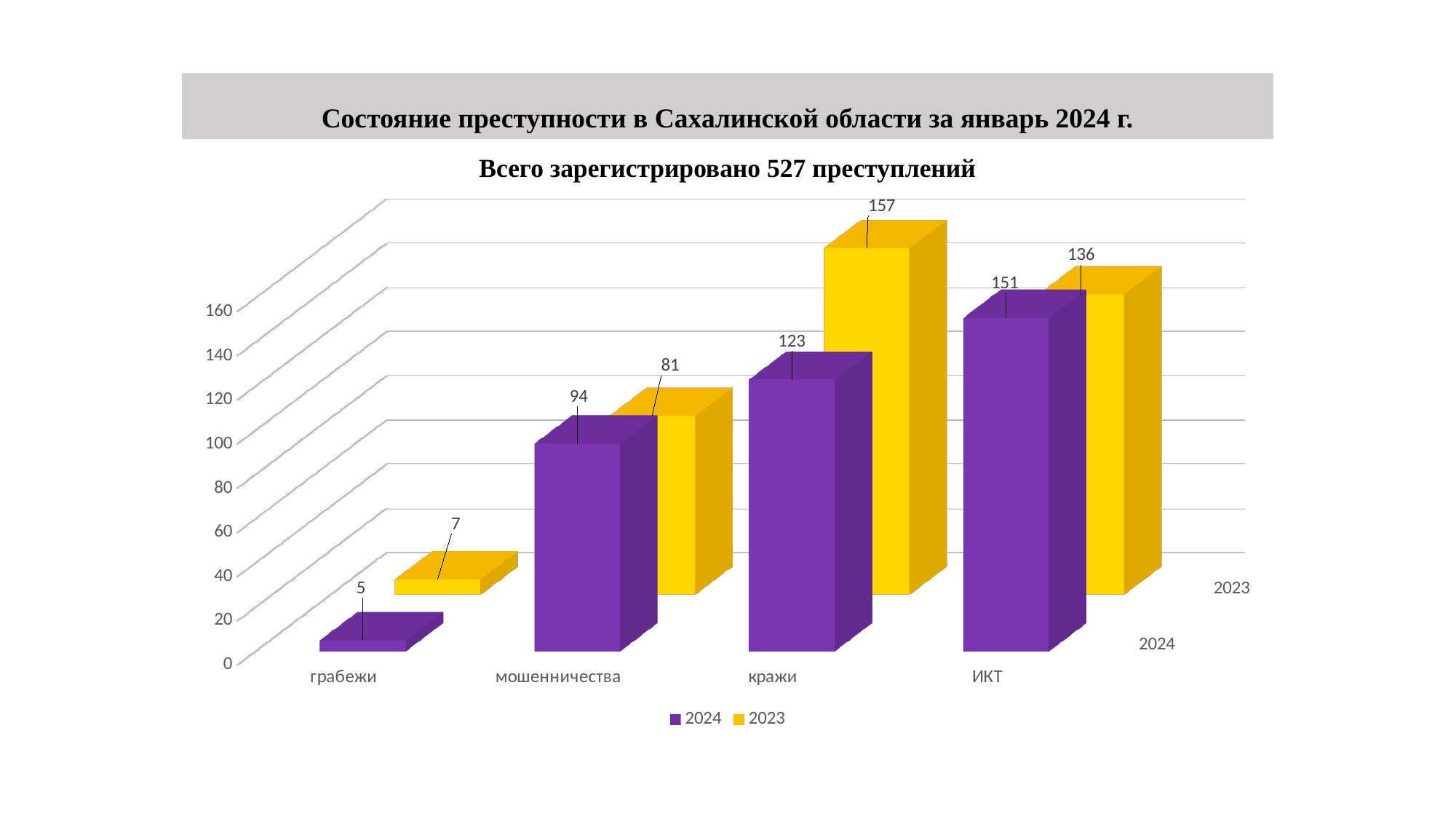
How many series does the legend list? 2 What is the difference between the 2023 and 2024 values for кражи? 34 Which category has the highest value in the 2023 series? кражи Which category has the lowest value in the 2024 series? грабежи What kind of chart is shown on the slide? bar chart What colour represents the 2023 series? yellow What is the value for ИКТ in the 2024 series? 151 What is the value for грабежи in the 2023 series? 7 What is the value for мошенничества in the 2023 series? 81 Which is larger for ИКТ: the 2024 value or the 2023 value? 2024 How many categories are shown on the x axis? 4 What is the value for кражи in the 2024 series? 123